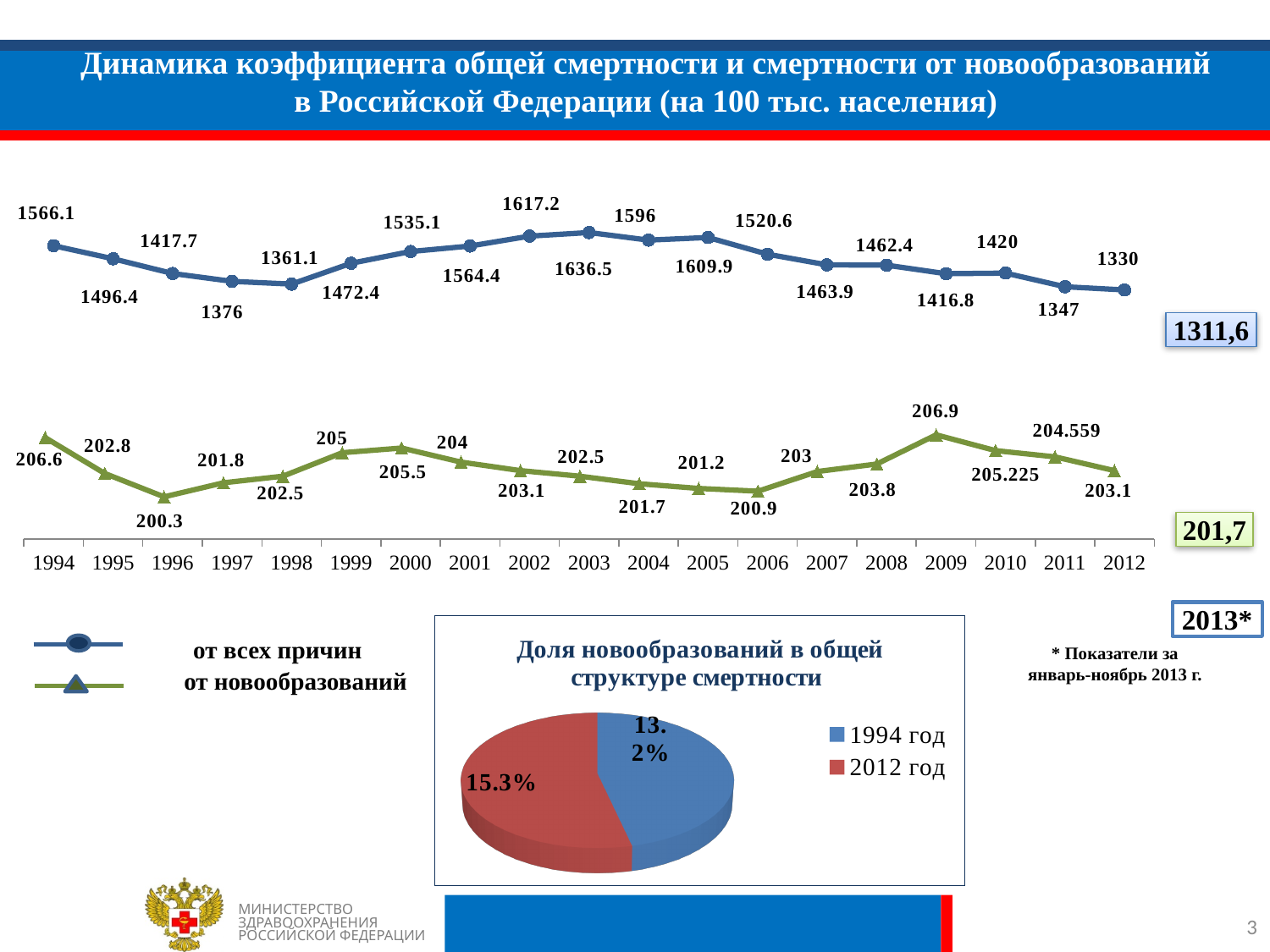
How many series does the legend of the line chart list? 2 In the line chart, what is the difference between the 'от всех причин' values for 1994 and 2012? 236.1 In the line chart, what is the value for 'от всех причин' in 2012? 1330 In the line chart, is the 'от новообразований' value higher in 1994 or in 2012? 1994 In the line chart, what is the value for 'от всех причин' in 2003? 1636.5 In the line chart, which year has the lowest value for 'от новообразований'? 1996 In the line chart, what is the value for 'от новообразований' in 2009? 206.9 In the line chart, which year has the highest value for 'от всех причин'? 2003 In the pie chart 'Доля новообразований в общей структуре смертности', what is the share for 2012 год? 15.3% How many years are shown on the x axis of the line chart? 19 In the line chart, which year has the lowest value for 'от всех причин'? 1998 What kind of chart is 'Доля новообразований в общей структуре смертности'? Pie chart